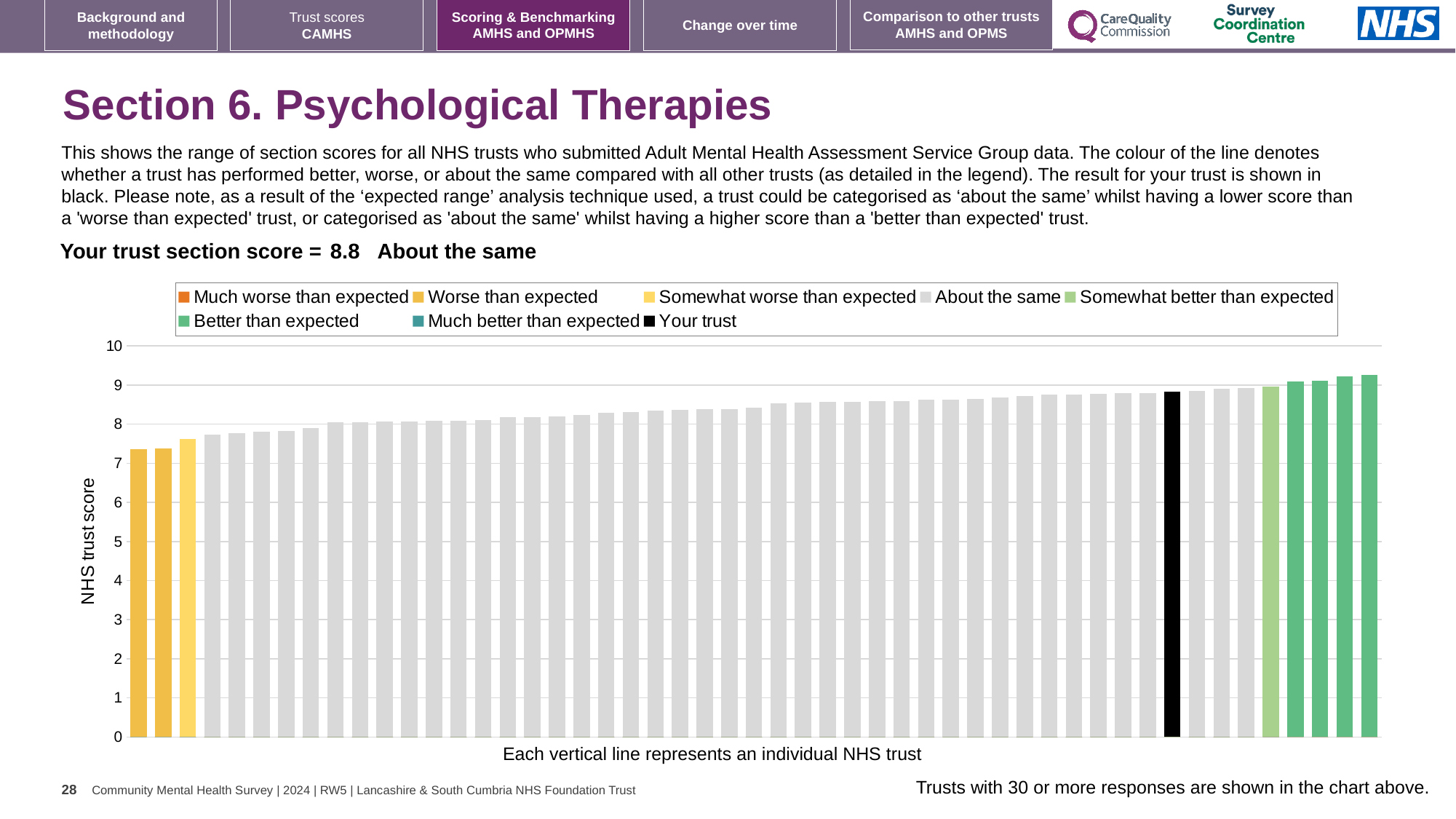
Which legend category does the highest bar in the chart belong to? Better than expected What kind of chart is shown on the slide? bar chart Is the value of the leftmost bar greater or less than 8? less What is the label on the vertical axis of the chart? NHS trust score How many bars are coloured as 'Somewhat better than expected' (light green)? 1 What is the section score for your trust shown on the slide? 8.8 Do the bar values rise or fall from left to right across the chart? rise How many bars are coloured as 'Better than expected' (green)? 4 Is the value of the rightmost bar greater or less than 9? greater How many entries does the chart legend list? 8 How many bars are coloured as 'Worse than expected' (dark yellow)? 2 Which is larger: the score for your trust (black bar) or the score of the leftmost bar? your trust